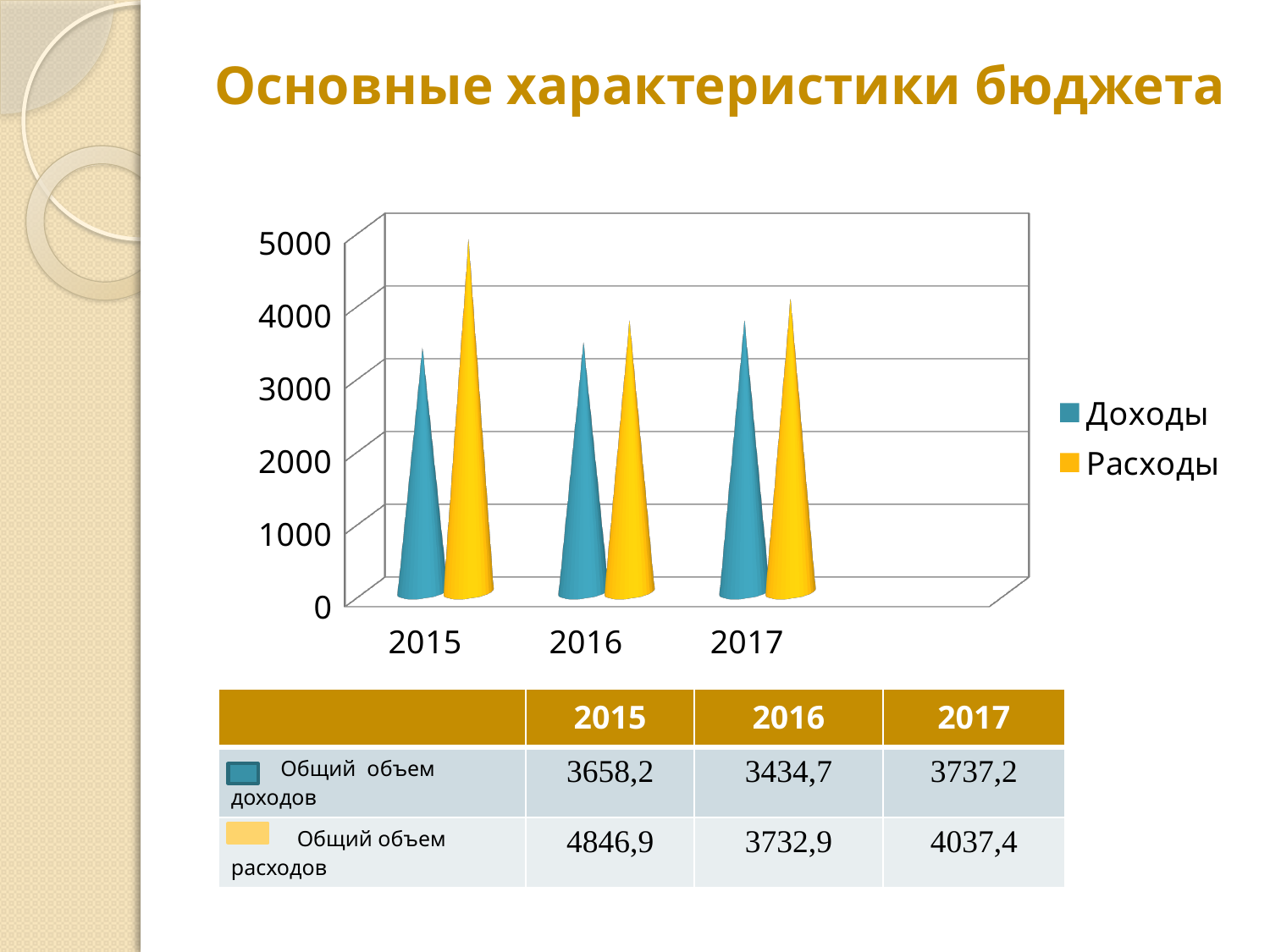
How many series does the chart legend list? 2 What is the value of Доходы for 2016? 3434,7 Do Расходы rise or fall from 2016 to 2017? rise What is the value of Расходы for 2017? 4037,4 What is the difference between Расходы and Доходы in 2017? 300,2 In 2016, which is larger: Доходы or Расходы? Расходы How many years are shown on the x axis of the chart? 3 In which year are Расходы the highest? 2015 By how much do Расходы exceed Доходы in 2015? 1188,7 Is the value of Расходы for 2015 greater or less than 4000? greater In which year are Доходы the lowest? 2016 What is the value of Доходы for 2015? 3658,2